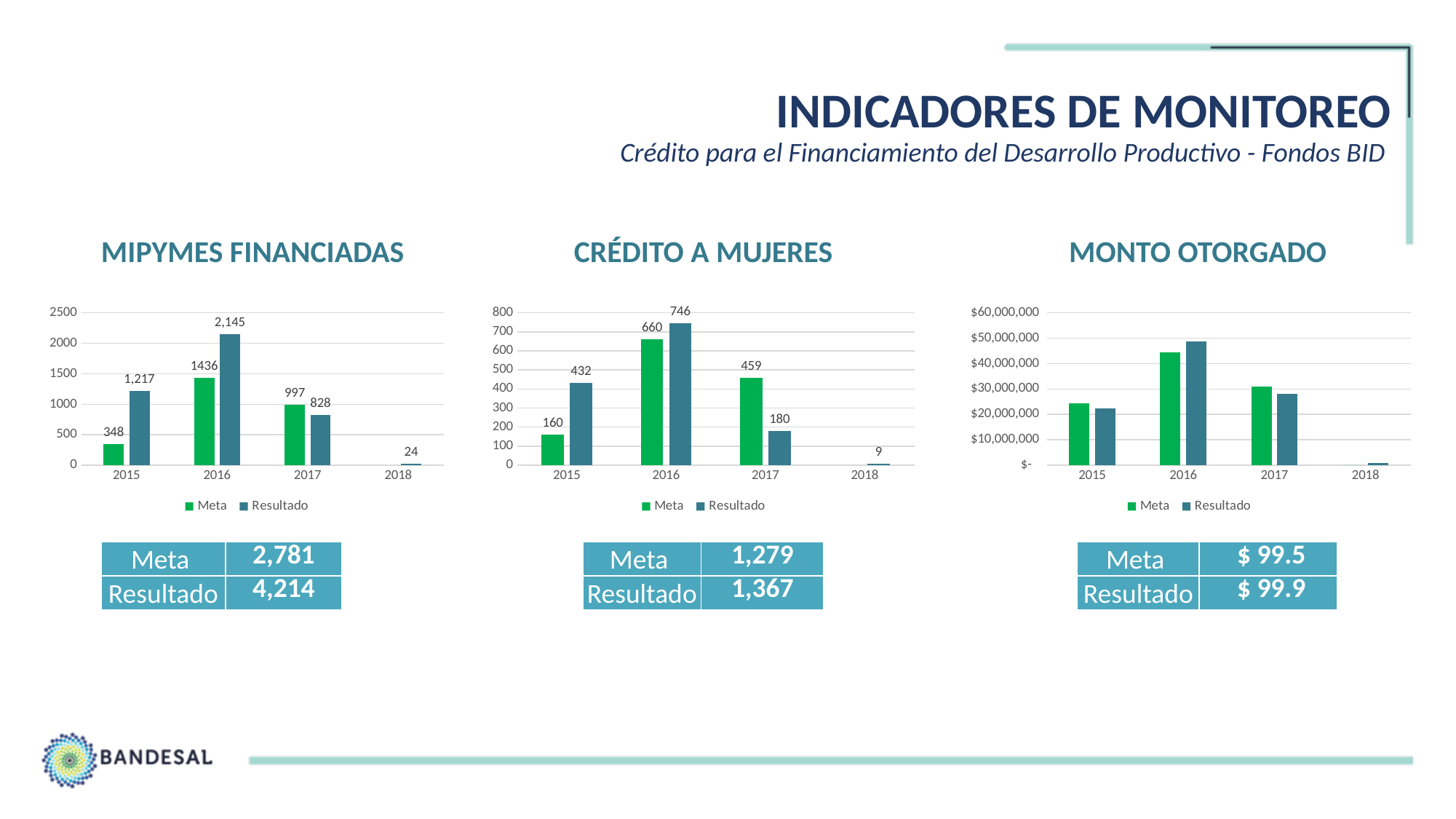
What kind of chart is the CRÉDITO A MUJERES chart? Bar chart In the MIPYMES FINANCIADAS chart, what is the Resultado value for 2016? 2,145 In the MONTO OTORGADO chart, is the Resultado value for 2017 greater or less than $30,000,000? less In the CRÉDITO A MUJERES chart, which is larger for 2017, Meta or Resultado? Meta In the CRÉDITO A MUJERES chart, what is the difference between the Resultado and Meta values for 2016? 86 In the MIPYMES FINANCIADAS chart, what is the Meta value for 2017? 997 In the MIPYMES FINANCIADAS chart, what is the difference between the Resultado and Meta values for 2015? 869 In the MONTO OTORGADO chart, is the Meta value for 2016 greater or less than $40,000,000? greater In the MIPYMES FINANCIADAS chart, which year has the highest Resultado value? 2016 In the CRÉDITO A MUJERES chart, which year has the lowest Resultado value? 2018 In the CRÉDITO A MUJERES chart, what is the Resultado value for 2017? 180 How many series does the legend of the MONTO OTORGADO chart list? 2